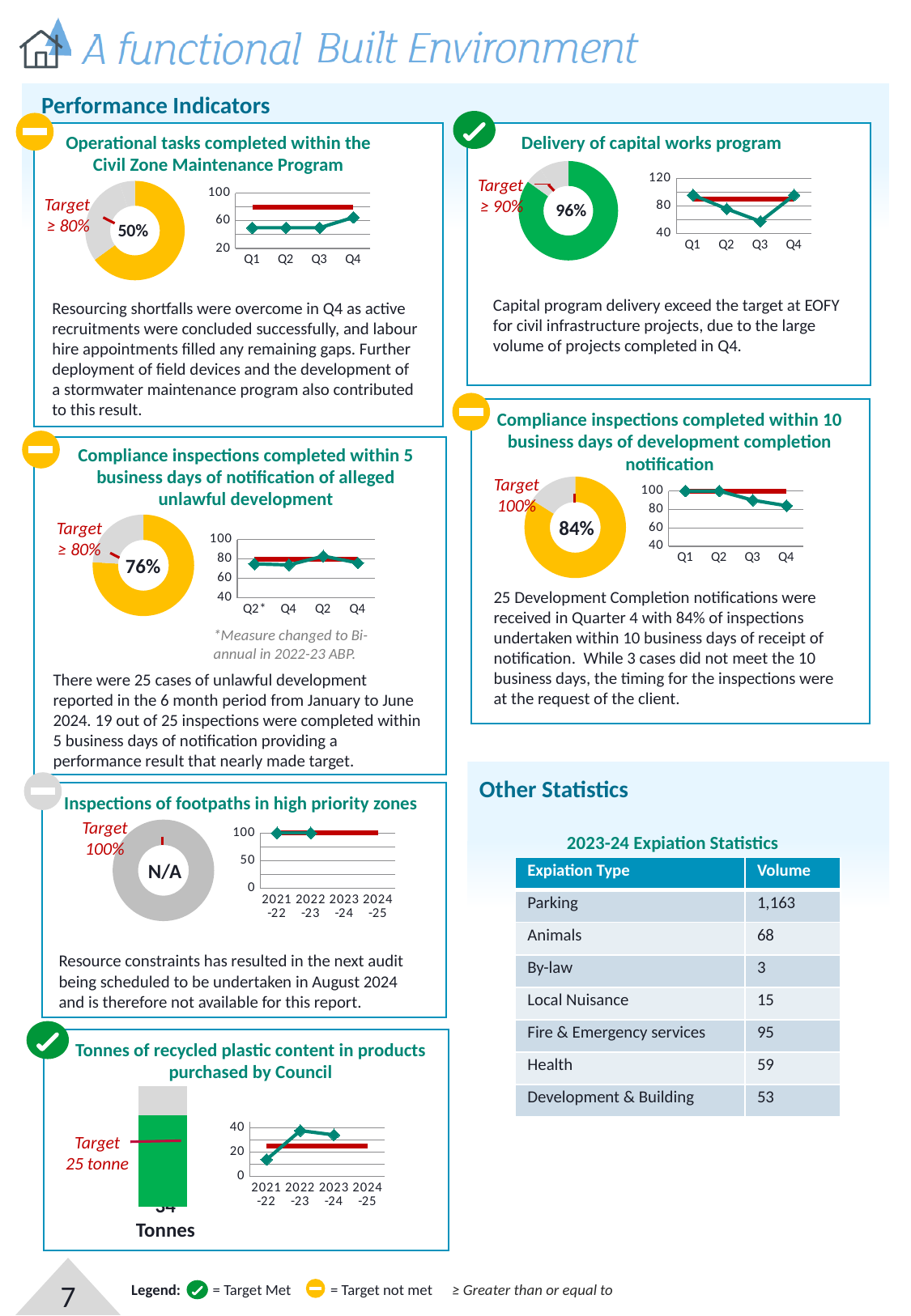
In the 'Delivery of capital works program' donut chart, what percentage is shown? 96% In the 'Compliance inspections completed within 5 business days of notification of alleged unlawful development' donut chart, what percentage is shown? 76% In the 'Delivery of capital works program' line chart, is the value for Q3 greater or less than 80? less In the 'Compliance inspections completed within 10 business days of development completion notification' donut chart, what percentage is shown? 84% In the 'Inspections of footpaths in high priority zones' donut chart, what value is shown in the centre? N/A In the 'Tonnes of recycled plastic content in products purchased by Council' line chart, is the value for 2021-22 greater or less than 20? less In the 'Tonnes of recycled plastic content in products purchased by Council' panel, what kind of chart is the one on the right with years on the x axis? line chart In the 'Operational tasks completed within the Civil Zone Maintenance Program' donut chart, what percentage is shown? 50% How many quarters are shown on the x axis of the 'Operational tasks completed within the Civil Zone Maintenance Program' line chart? 4 In the 'Compliance inspections completed within 10 business days of development completion notification' line chart, do the values rise or fall from Q1 to Q4? fall In the 'Operational tasks completed within the Civil Zone Maintenance Program' line chart, is the value for Q4 greater or less than 60? greater What target is stated next to the 'Delivery of capital works program' donut chart? ≥ 90%